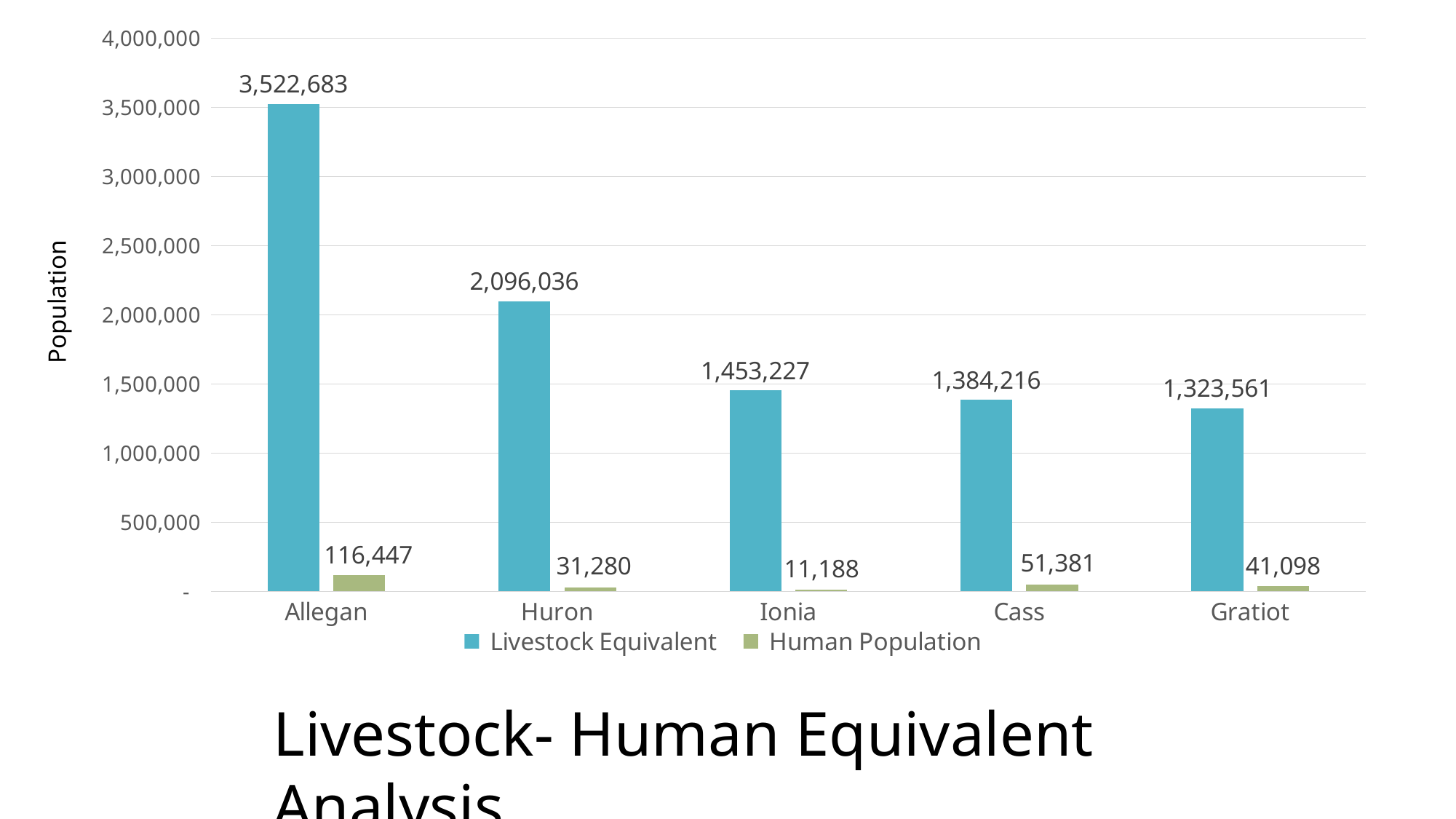
Which county has the highest Livestock Equivalent? Allegan How many counties are shown on the x axis? 5 What is the Livestock Equivalent value for Gratiot? 1,323,561 What is the Human Population value for Ionia? 11,188 Which county has the lowest Human Population? Ionia What kind of chart is shown on the slide? bar chart What is the difference between the Livestock Equivalent and the Human Population for Allegan? 3,406,236 Which is larger, the Livestock Equivalent for Huron or for Ionia? Huron What is the difference between the Human Population of Cass and that of Gratiot? 10,283 Is the Livestock Equivalent for Cass greater or less than 1,500,000? less How many series does the legend list? 2 What is the Livestock Equivalent value for Allegan? 3,522,683